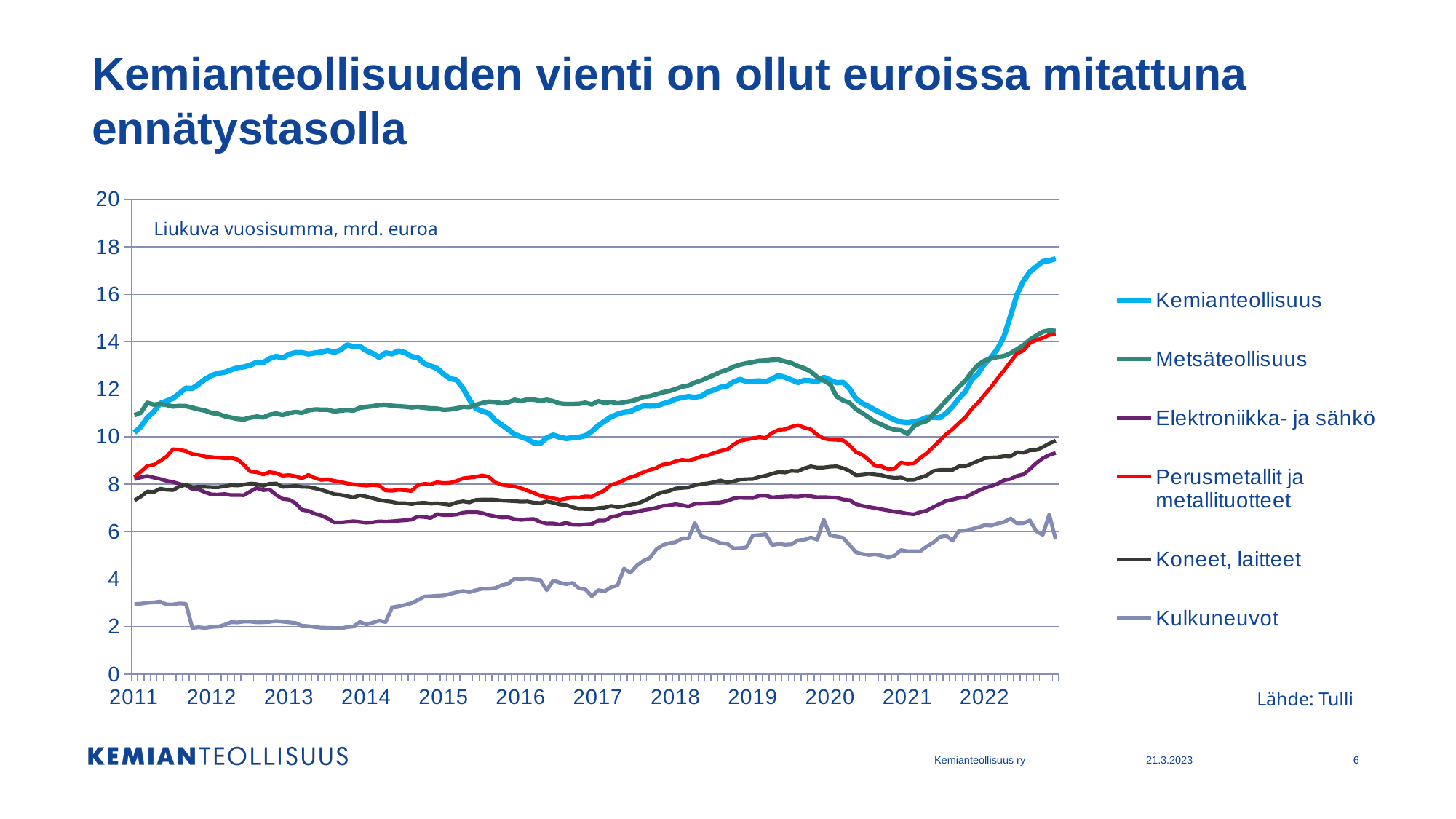
Does the Kemianteollisuus line rise or fall from 2021 to the end of 2022? rises What unit is stated in the text inside the chart area? Liukuva vuosisumma, mrd. euroa Which series has the lowest values throughout the whole period shown? Kulkuneuvot At the start of 2011, which is larger: Koneet, laitteet or Kulkuneuvot? Koneet, laitteet At the end of 2022, which is larger: Kemianteollisuus or Metsäteollisuus? Kemianteollisuus What kind of chart is shown on the slide? line chart Is the value for Kulkuneuvot at the start of 2011 greater or less than 4? less Which series has the highest value at the right end of the chart (end of 2022)? Kemianteollisuus Is the value for Metsäteollisuus at the start of 2016 greater or less than 10? greater Is the value for Kemianteollisuus at the end of 2022 greater or less than 16? greater How many series does the legend list? 6